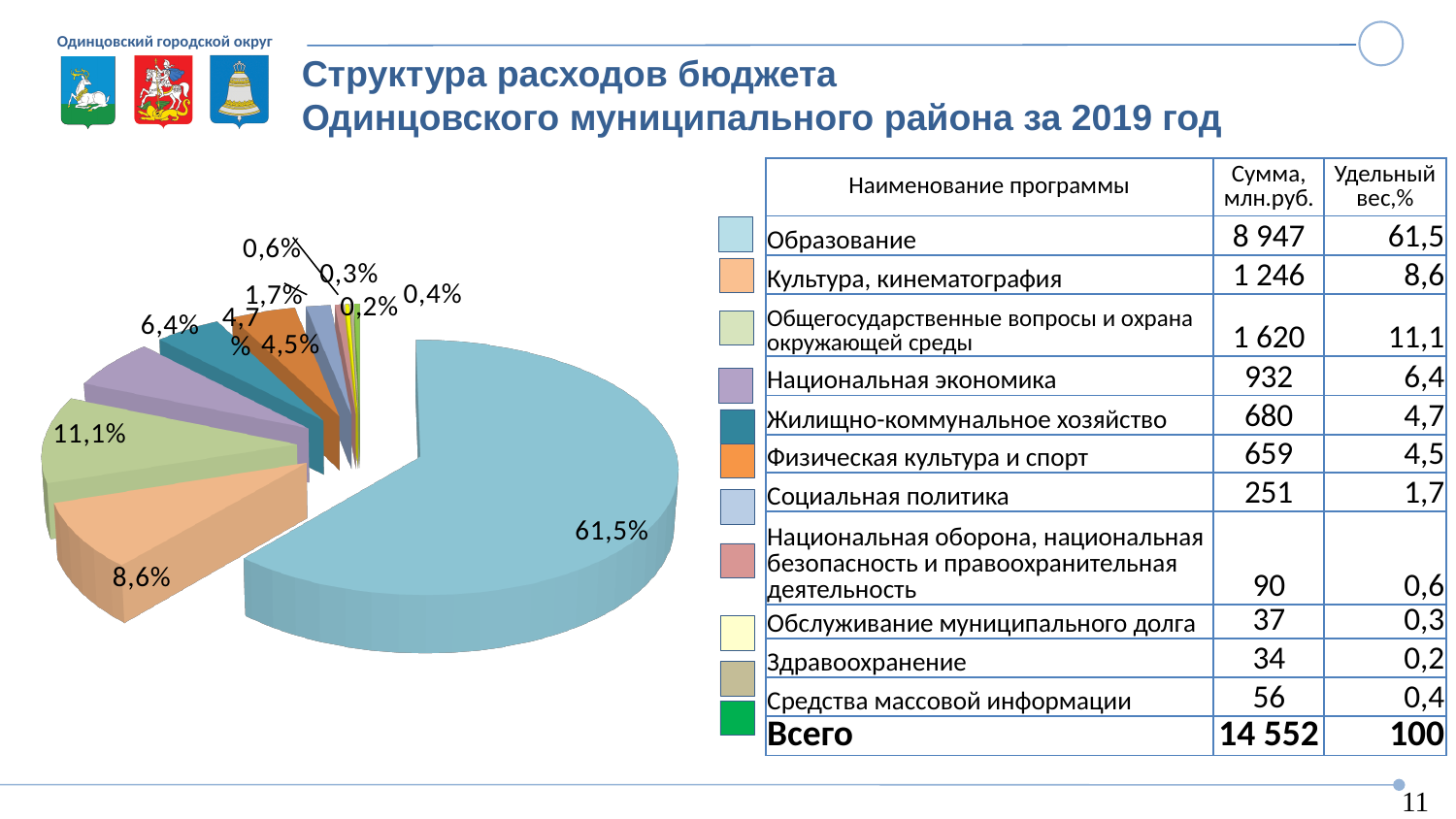
What share of the pie does Общегосударственные вопросы и охрана окружающей среды take? 11,1% What share of the pie does Национальная экономика take? 6,4% What is the difference in percentage points between the Образование slice (61,5%) and the Общегосударственные вопросы и охрана окружающей среды slice (11,1%)? 50,4 What share of the pie does the largest slice (Образование) take? 61,5% Which category has the smallest slice of the pie chart? Здравоохранение What is the smallest percentage label shown on the pie chart? 0,2% How many slices does the pie chart have? 11 What kind of chart is shown on the slide? pie chart What is the title of the slide containing the pie chart? Структура расходов бюджета Одинцовского муниципального района за 2019 год Which slice is larger: Жилищно-коммунальное хозяйство or Социальная политика? Жилищно-коммунальное хозяйство Which category has the largest slice of the pie chart? Образование